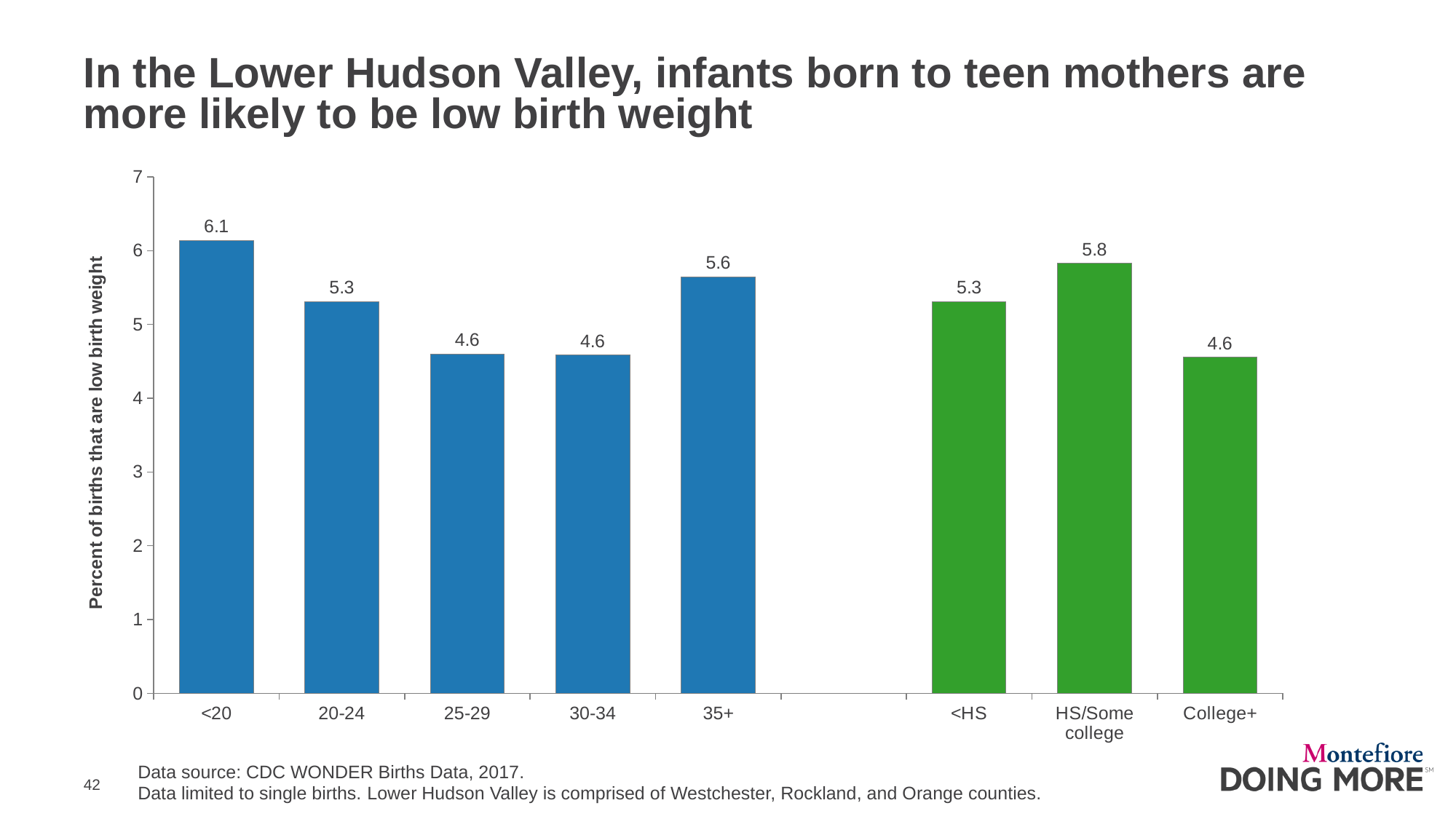
What kind of chart is shown on the slide? Bar chart How many categories are shown on the x axis? 8 What is the value for mothers aged 35+? 5.6 What is the difference between the values for HS/Some college and College+? 1.2 What is the label of the y axis? Percent of births that are low birth weight Is the value for <HS greater or less than 5? greater Which category has the highest percent of low birth weight births? <20 What is the difference between the values for <20 and 25-29? 1.5 What is the percent of births that are low birth weight for mothers aged <20? 6.1 What is the value for the HS/Some college category? 5.8 Which is larger, the value for 20-24 or the value for 35+? 35+ Among the education categories (<HS, HS/Some college, College+), which has the lowest value? College+